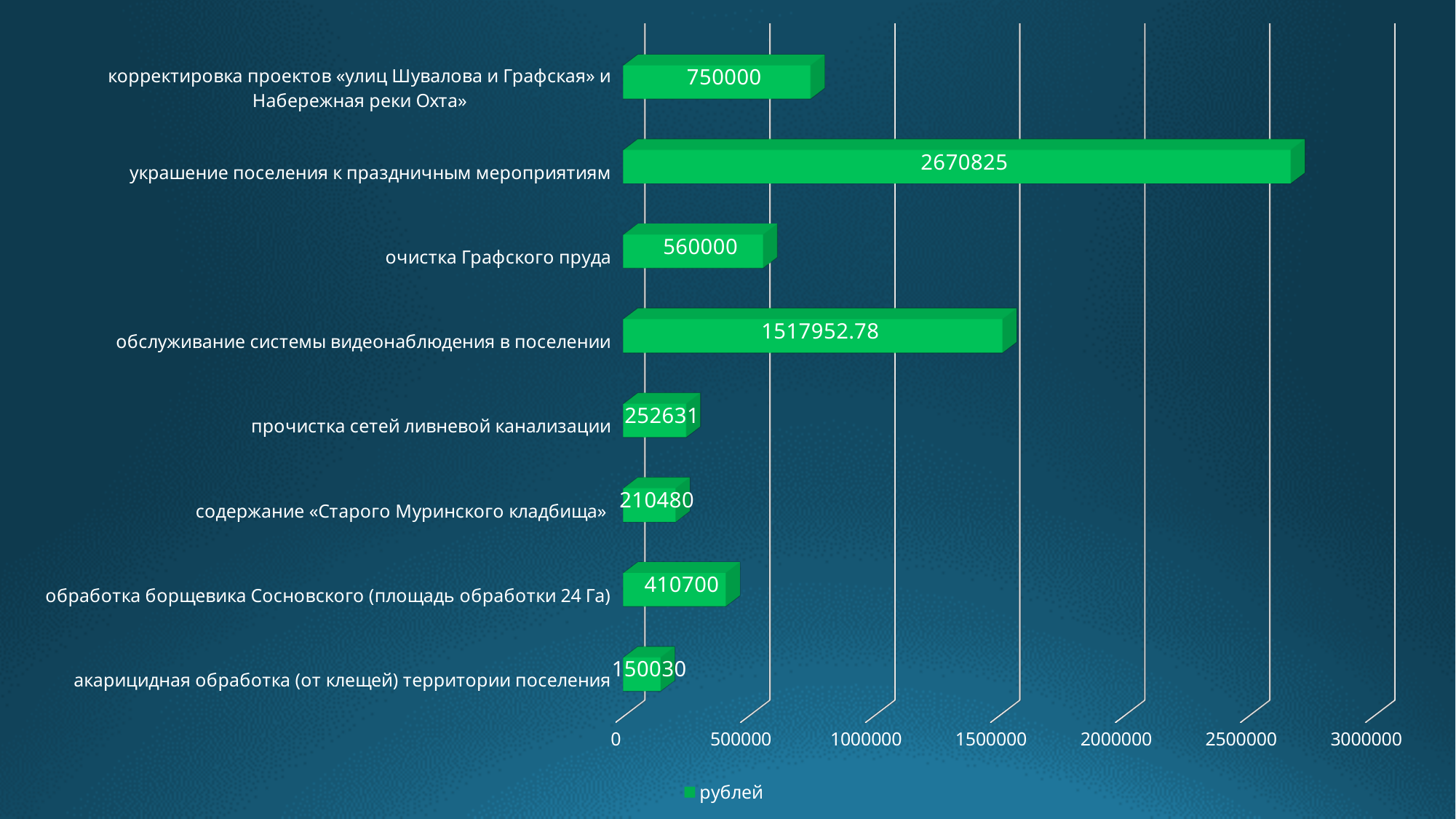
What kind of chart is shown on the slide? bar chart Which is larger: the value for «обработка борщевика Сосновского (площадь обработки 24 Га)» or the value for «прочистка сетей ливневой канализации»? обработка борщевика Сосновского (площадь обработки 24 Га) What is the difference between the values for «корректировка проектов «улиц Шувалова и Графская» и Набережная реки Охта»» and «очистка Графского пруда»? 190000 What series name does the legend show? рублей What is the value for «украшение поселения к праздничным мероприятиям»? 2670825 What is the value for «обслуживание системы видеонаблюдения в поселении»? 1517952.78 Which category has the highest value? украшение поселения к праздничным мероприятиям Which category has the lowest value? акарицидная обработка (от клещей) территории поселения How many categories are shown in the chart? 8 What is the value for «акарицидная обработка (от клещей) территории поселения»? 150030 What is the value for «очистка Графского пруда»? 560000 Is the value for «обслуживание системы видеонаблюдения в поселении» greater or less than 1000000? greater